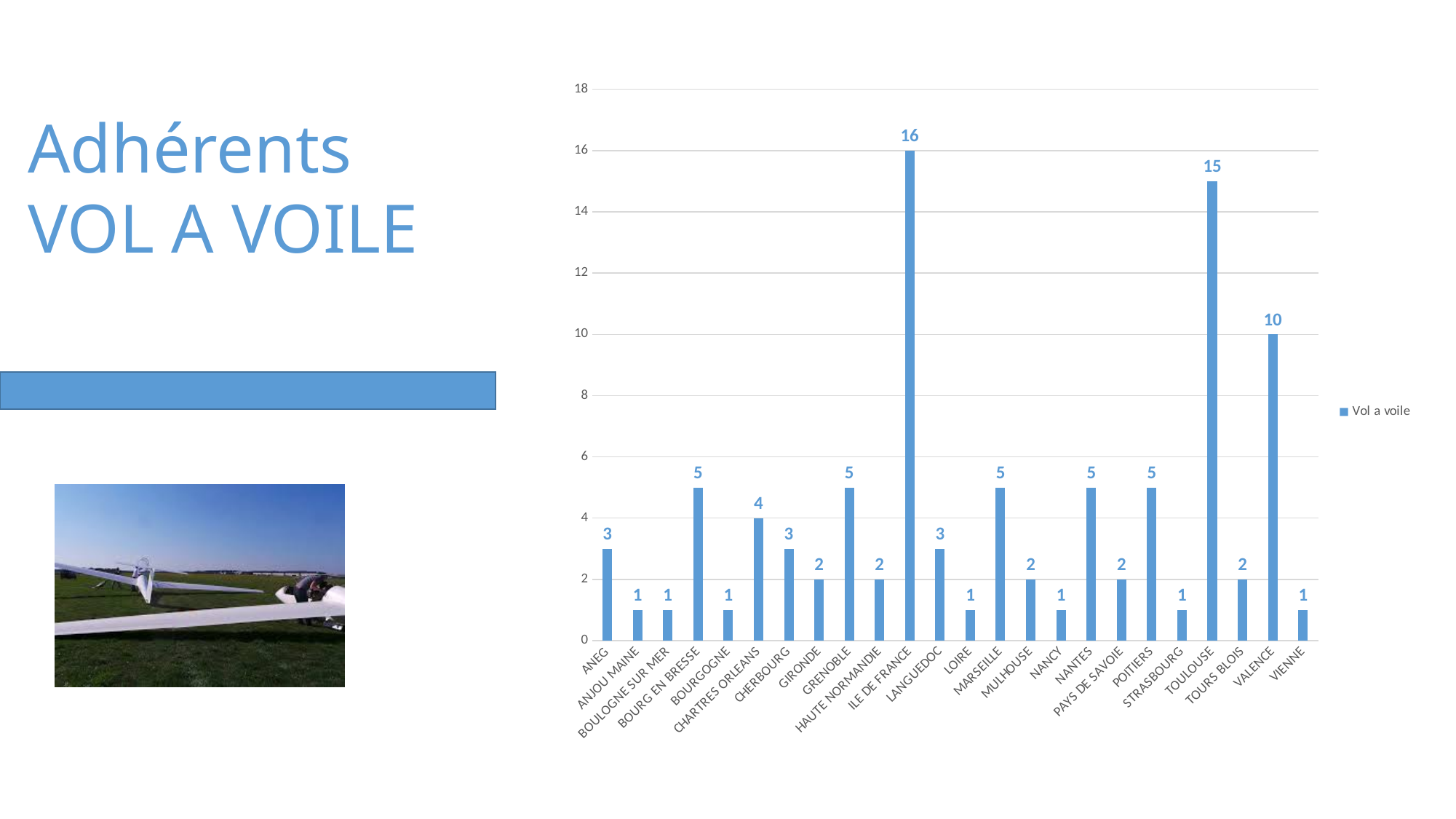
What is the value for CHARTRES ORLEANS? 4 What is the difference between the values for ILE DE FRANCE and TOULOUSE? 1 What is the value for TOULOUSE? 15 How many series does the legend list? 1 How many categories are shown on the x axis? 24 What is the value for ILE DE FRANCE? 16 Is the value for TOULOUSE greater or less than 12? greater What is the difference between the values for VALENCE and GRENOBLE? 5 Which category has the highest value? ILE DE FRANCE What is the value for VALENCE? 10 What kind of chart is shown on the slide? bar chart Which is larger, the value for ANEG or the value for GIRONDE? ANEG